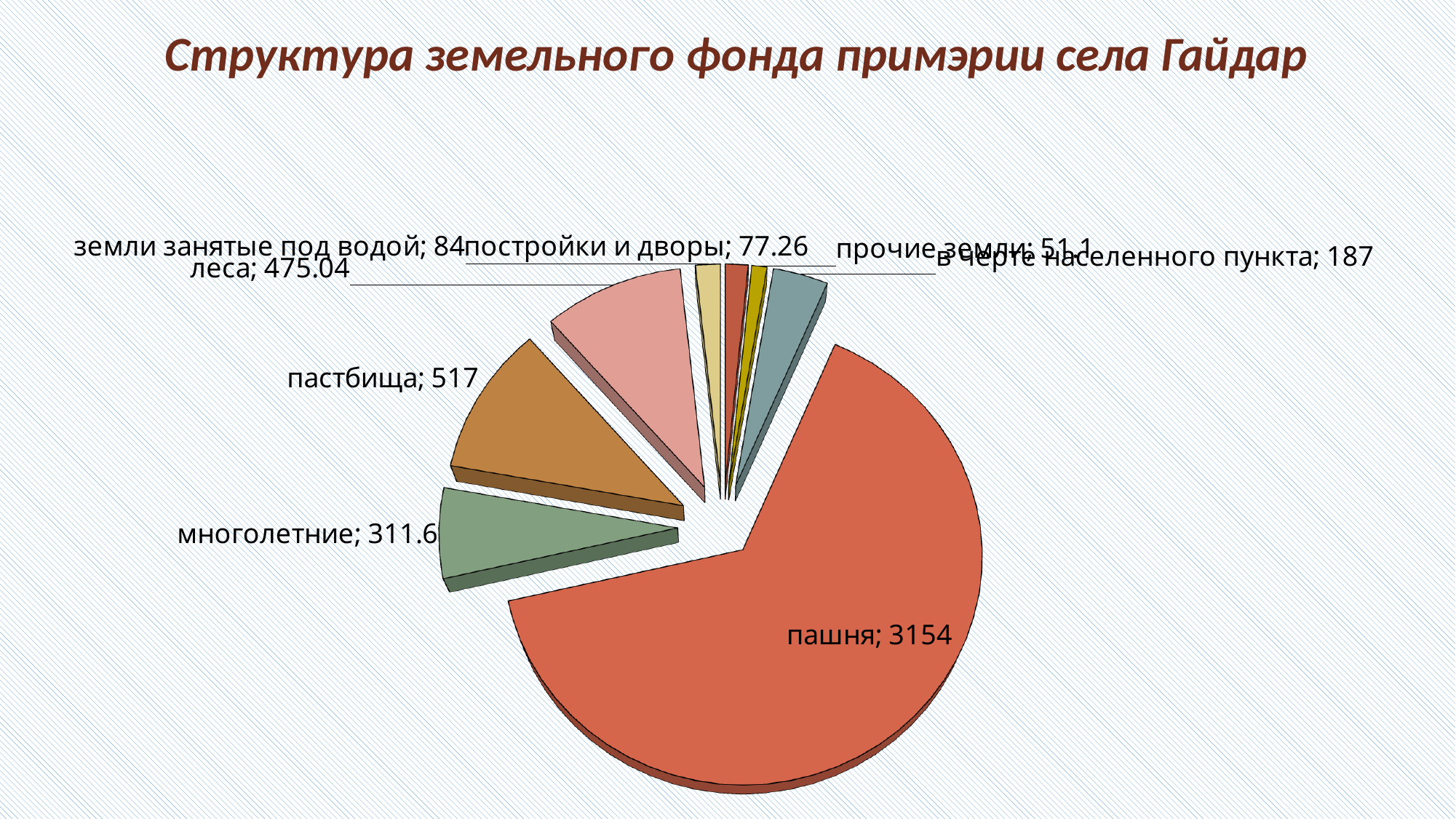
What is the difference between пастбища and леса? 41.96 What is the value for многолетние? 311.6 What is the value for земли занятые под водой? 84 What is the value for пастбища? 517 What is the value for леса? 475.04 Which is larger, пастбища or леса? пастбища What is the value for пашня? 3154 How many slices does the pie chart have? 8 What type of chart is shown on the slide? pie chart Which category has the largest slice? пашня What is the value for в черте населенного пункта? 187 What is the value for постройки и дворы? 77.26